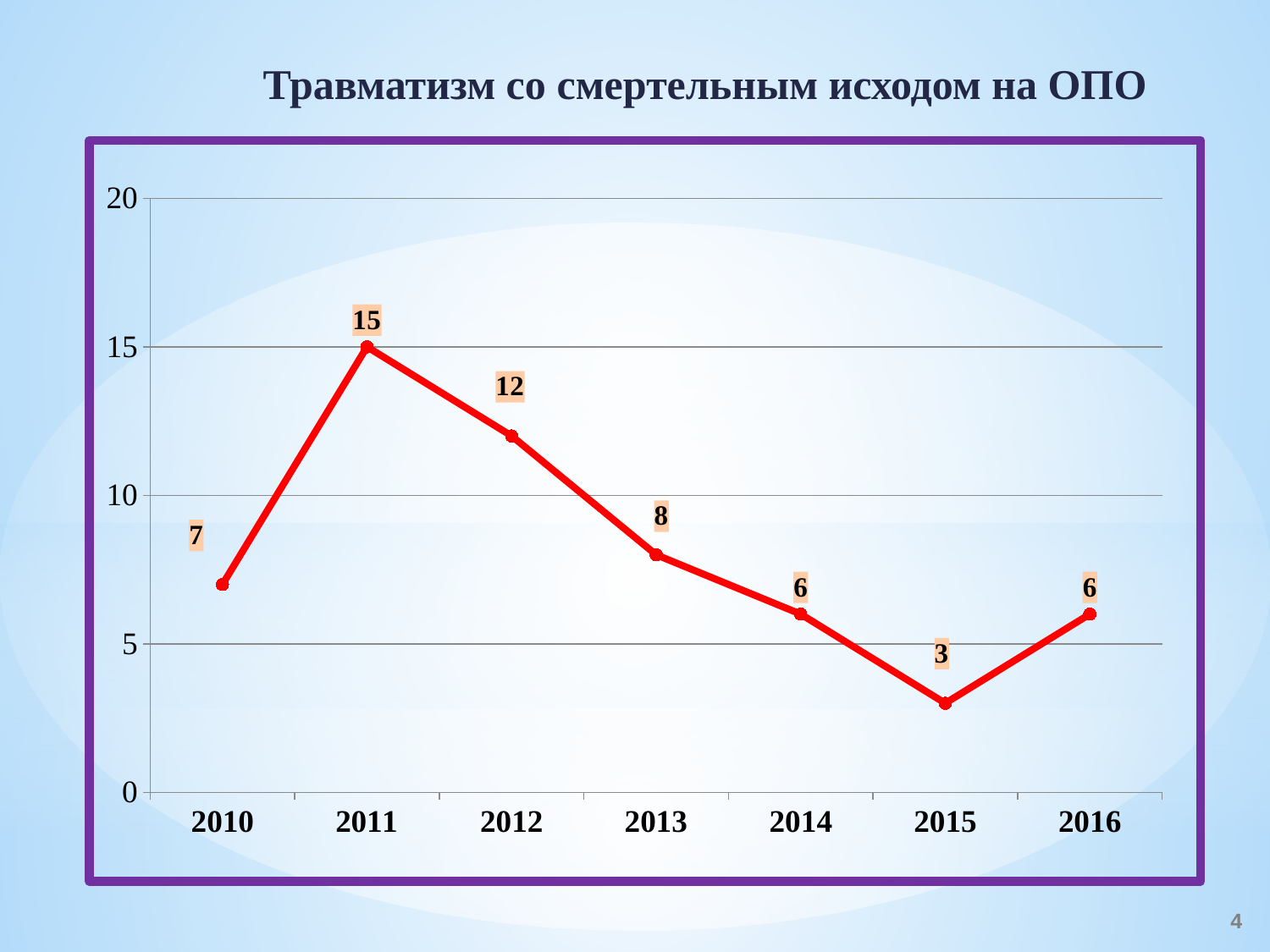
Do the values rise or fall from 2011 to 2015? fall What is the value for 2015? 3 Which is larger, the value for 2013 or the value for 2014? 2013 Which year has the highest value? 2011 What is the value for 2011? 15 What is the difference between the values for 2010 and 2015? 4 How many years are plotted on the chart? 7 Which year has the lowest value? 2015 Is the value for 2012 greater or less than 10? greater What is the difference between the values for 2011 and 2012? 3 What is the value for 2010? 7 What kind of chart is shown on the slide? line chart